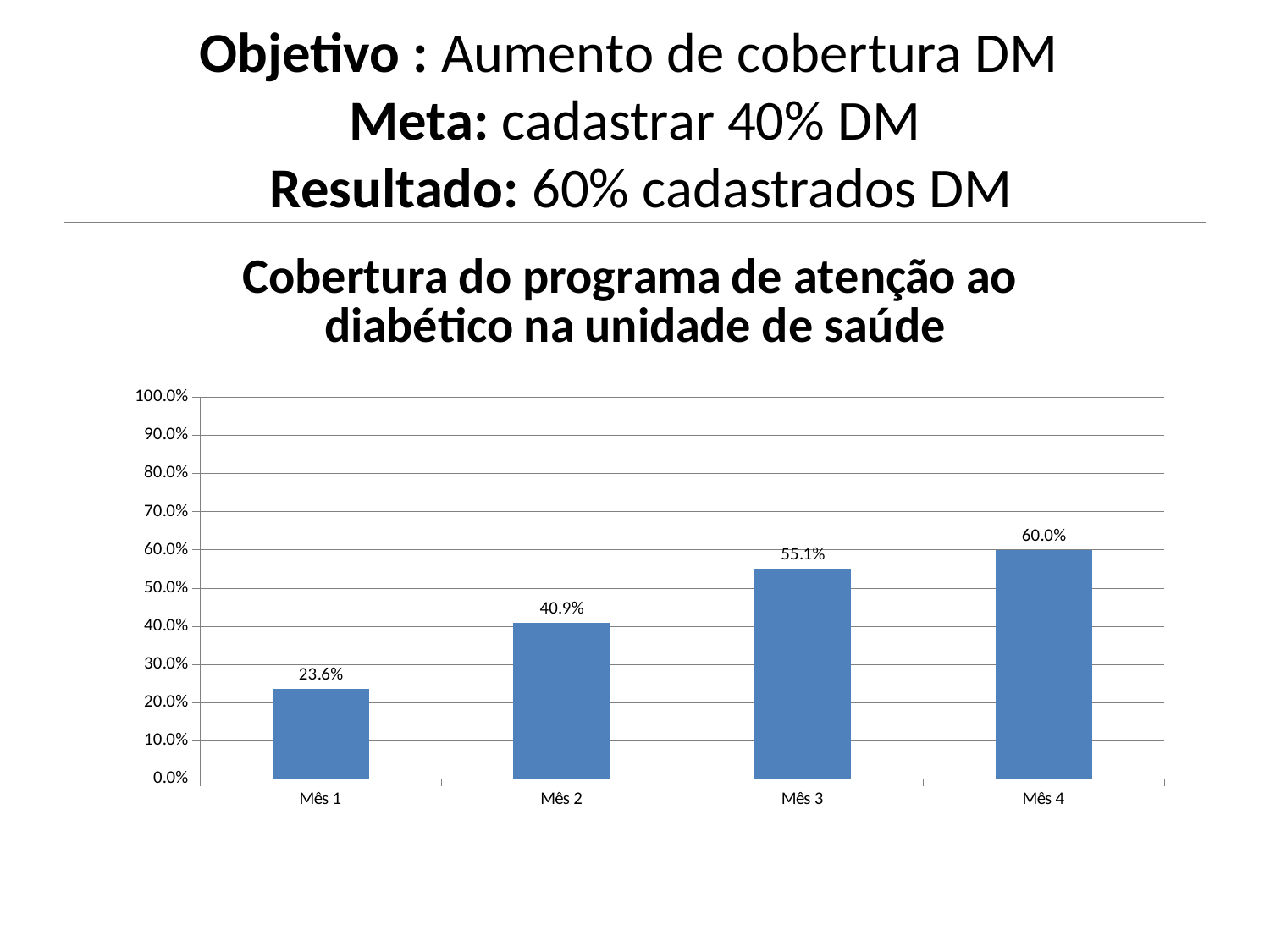
Which month has the highest value? Mês 4 What is the value for Mês 4? 60.0% What is the value for Mês 1? 23.6% Which month has the lowest value? Mês 1 What is the value for Mês 2? 40.9% What is the difference between the values for Mês 4 and Mês 1? 36.4% Which is larger, the value for Mês 2 or the value for Mês 3? Mês 3 What is the value for Mês 3? 55.1% What kind of chart is this? Bar chart What is the difference between the values for Mês 3 and Mês 2? 14.2% Do the values rise or fall from Mês 1 to Mês 4? Rise How many months are shown on the x axis? 4